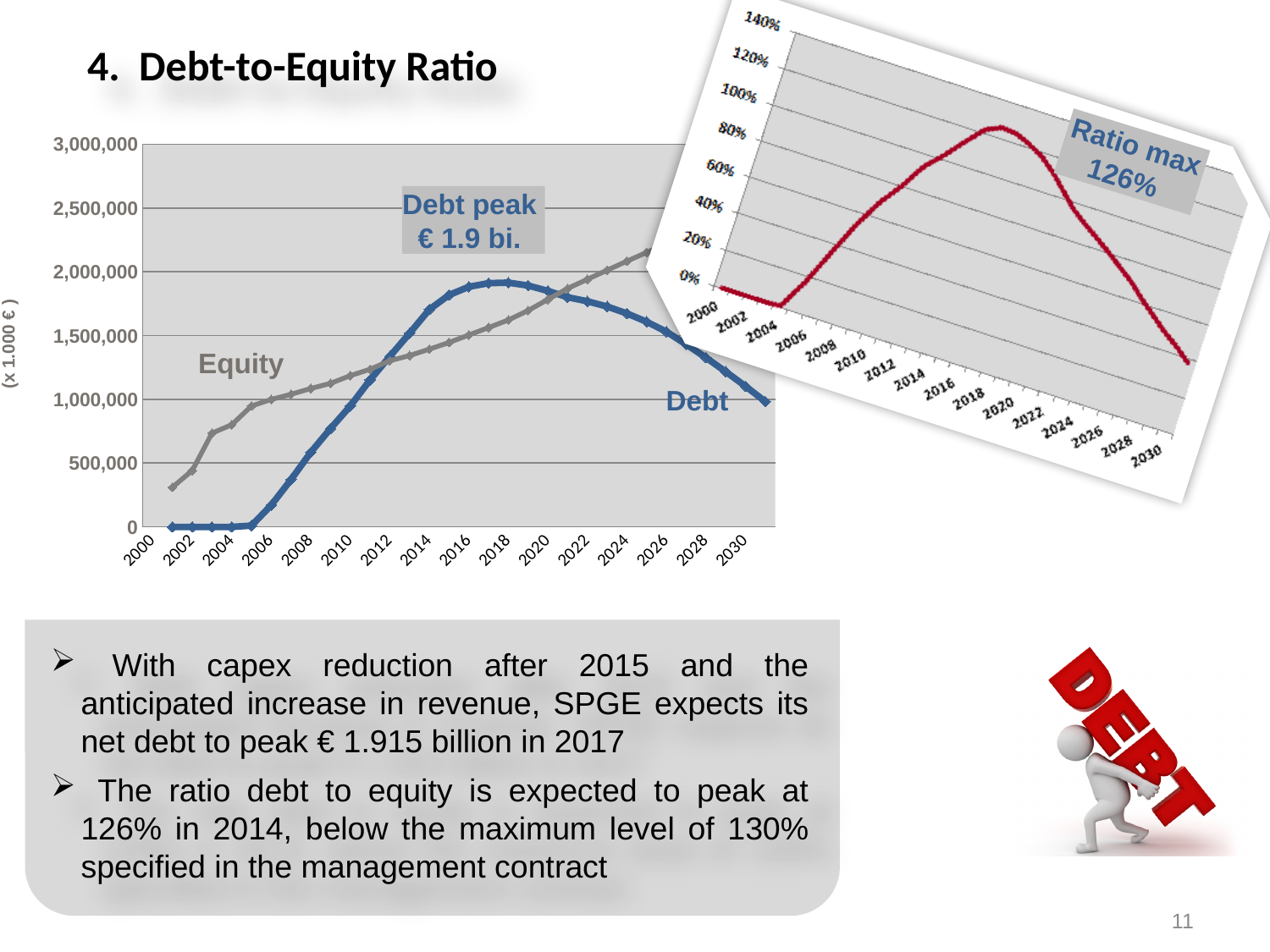
What kind of chart is the left chart showing Debt and Equity? line chart In the left chart, does Equity rise or fall from 2000 to 2030? rise In the left chart, which series is higher in 2026, Debt or Equity? Equity In the left chart, how many series are plotted? 2 In the left chart, is the value for Debt in 2008 greater or less than 500,000? greater In the right chart (debt-to-equity ratio), what is the maximum ratio as labelled on the slide? 126% In the left chart, what is the peak value of Debt as labelled on the slide? € 1.9 bi. In the left chart, which series is higher in 2018, Debt or Equity? Debt In the left chart, is the value for Debt in 2018 greater or less than 1,500,000? greater In the left chart, is the value for Equity in 2026 greater or less than 2,000,000? greater In the left chart, does Debt rise or fall between 2018 and 2030? fall